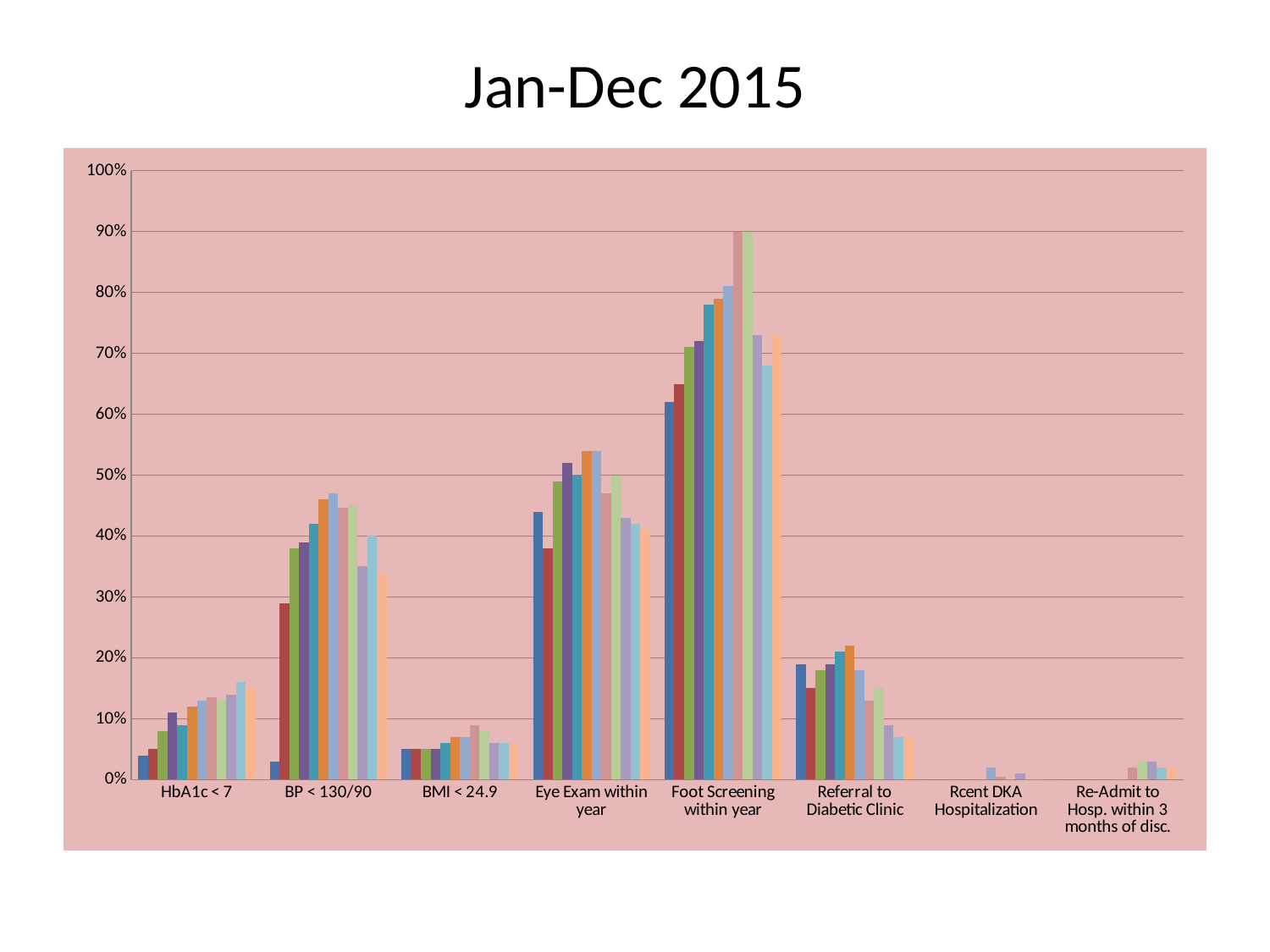
Is the tallest bar in the HbA1c < 7 group greater or less than 20%? less Is the tallest bar in the Foot Screening within year group greater or less than 80%? greater Is the tallest bar in the BMI < 24.9 group greater or less than 10%? less How many bars are plotted in each category group? 12 What is the title of the slide above the chart? Jan-Dec 2015 Which category has the lowest values in the chart? Rcent DKA Hospitalization What kind of chart is shown on the slide? Bar chart How many categories are shown along the x axis of the chart? 8 Which category has the tallest bars in the chart? Foot Screening within year Which category has higher values overall, Eye Exam within year or Referral to Diabetic Clinic? Eye Exam within year